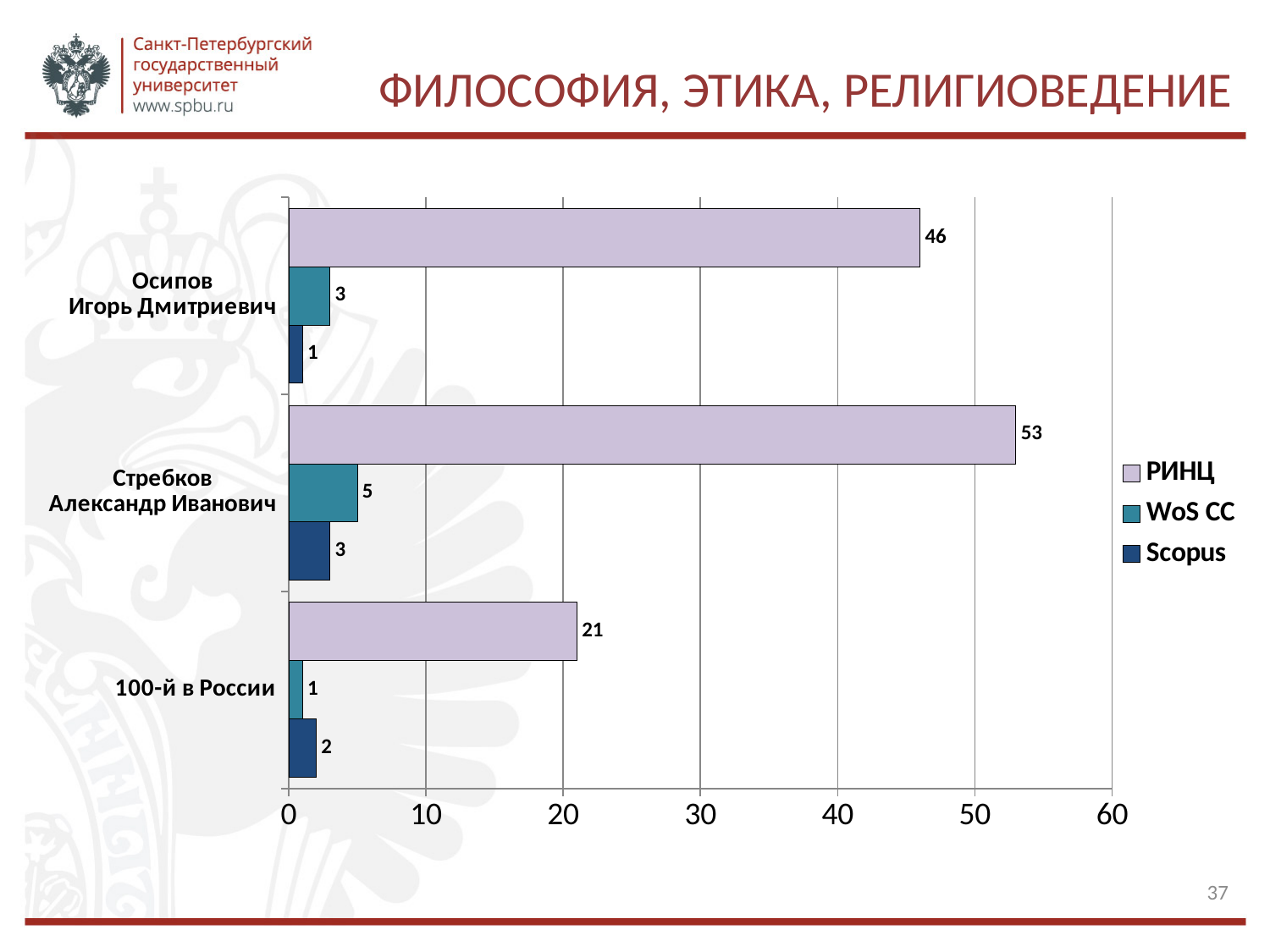
What kind of chart is shown on the slide? bar chart What is the Scopus value for 100-й в России? 2 What is the difference between the РИНЦ values for Стребков Александр Иванович and Осипов Игорь Дмитриевич? 7 How many categories are shown on the chart? 3 Which series is shown in the lightest colour in the legend? РИНЦ What is the РИНЦ value for Осипов Игорь Дмитриевич? 46 How many series does the legend list? 3 Which category has the highest РИНЦ value? Стребков Александр Иванович Which category has the lowest WoS CC value? 100-й в России Which is larger: the Scopus value for Стребков Александр Иванович or the Scopus value for 100-й в России? Стребков Александр Иванович Is the РИНЦ value for 100-й в России greater or less than 30? less What is the WoS CC value for Стребков Александр Иванович? 5